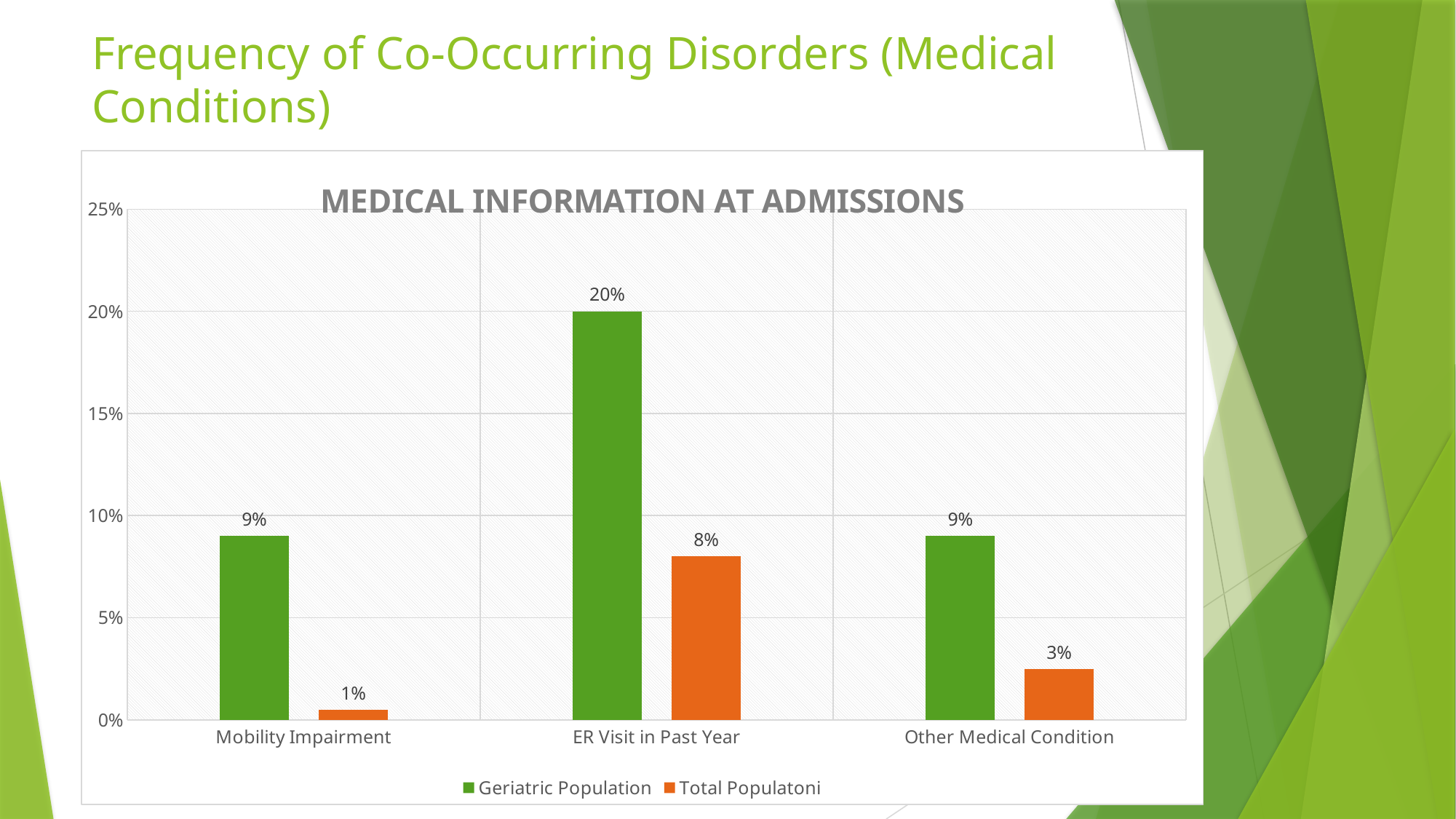
What is the Total Populatoni value for Other Medical Condition? 3% How many categories are shown on the x axis? 3 What is the Total Populatoni value for Mobility Impairment? 1% Which category has the lowest Total Populatoni value? Mobility Impairment What is the title of the chart? MEDICAL INFORMATION AT ADMISSIONS Which category has the highest Geriatric Population value? ER Visit in Past Year What kind of chart is shown on the slide? Bar chart What is the Geriatric Population value for ER Visit in Past Year? 20% How many series does the legend list? 2 What is the Geriatric Population value for Mobility Impairment? 9% Which is larger for Other Medical Condition: the Geriatric Population value or the Total Populatoni value? Geriatric Population What is the difference between the Geriatric Population and Total Populatoni values for ER Visit in Past Year? 12%